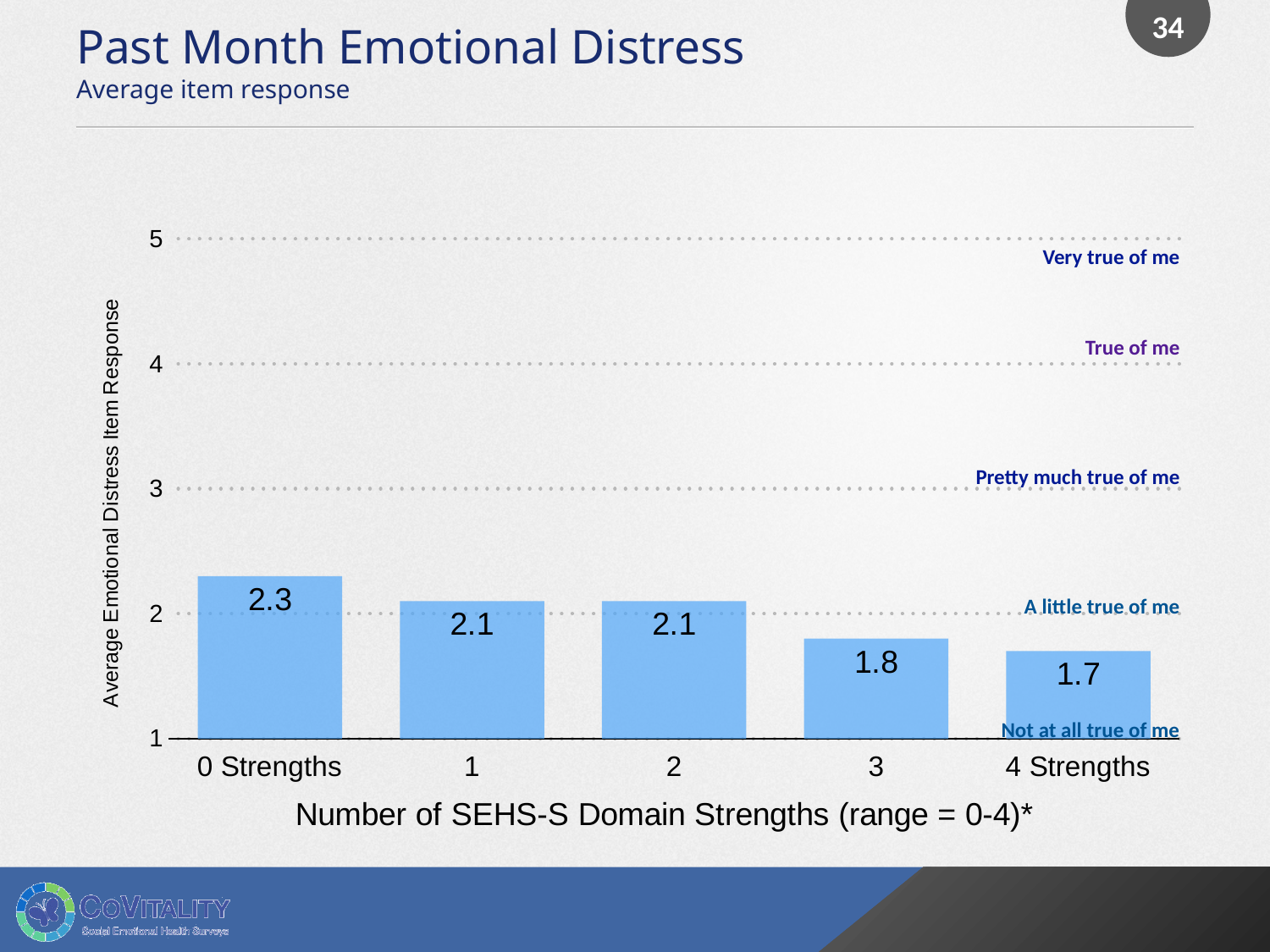
Which category has the highest average emotional distress item response? 0 Strengths Is the value for 0 Strengths greater or less than 2? greater What is the difference between the values for 2 strengths and 3 strengths? 0.3 Do the values rise or fall as the number of SEHS-S domain strengths increases? Fall What kind of chart is shown on the slide? Bar chart What is the difference between the values for 0 Strengths and 4 Strengths? 0.6 How many categories are shown on the x axis? 5 What is the average emotional distress item response for 4 Strengths? 1.7 What is the value shown for 3 strengths? 1.8 Which is larger, the value for 1 strength or the value for 3 strengths? 1 strength What is the average emotional distress item response for 0 Strengths? 2.3 Which category has the lowest average emotional distress item response? 4 Strengths